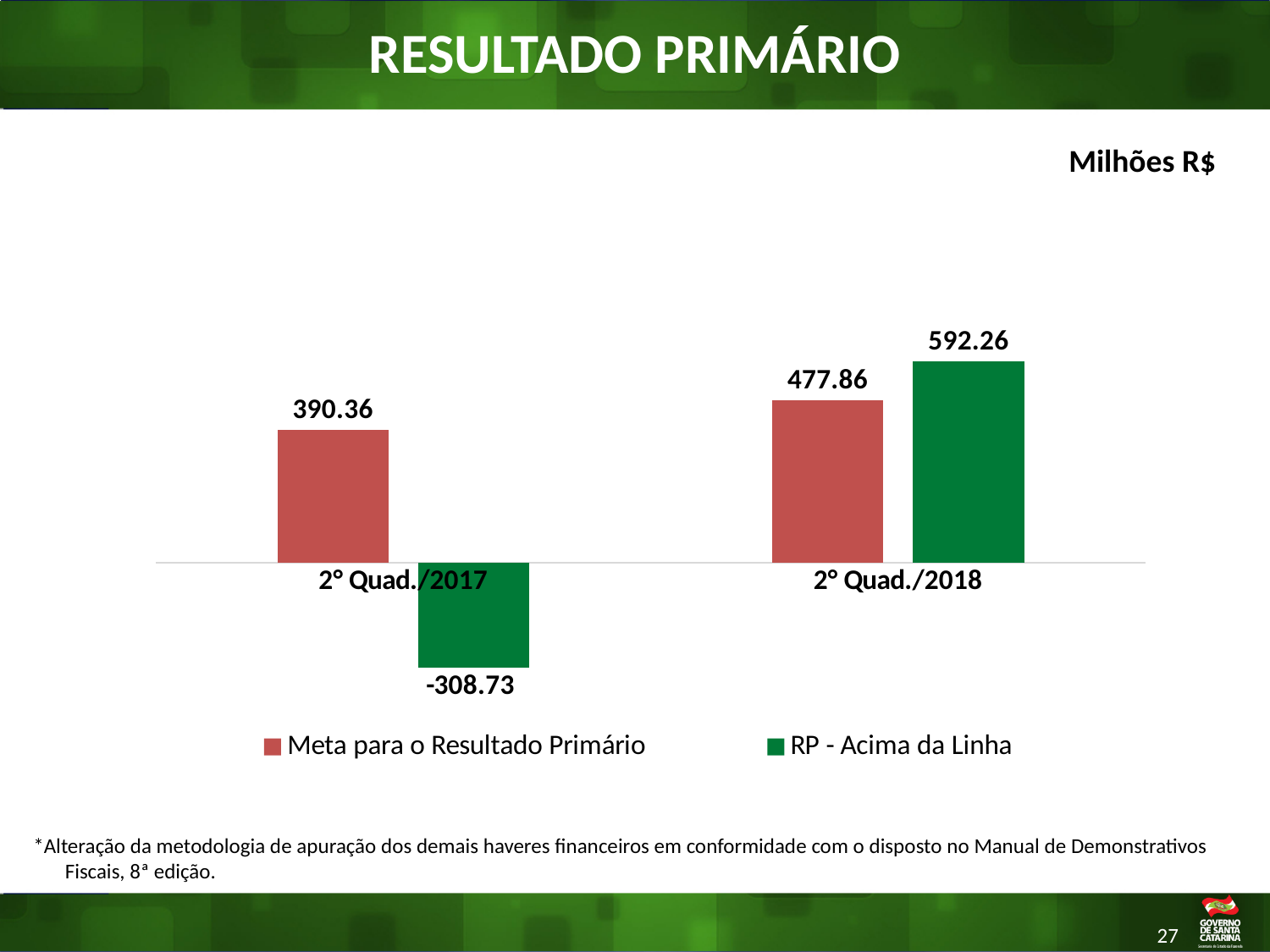
In 2° Quad./2017, which is larger: Meta para o Resultado Primário or RP - Acima da Linha? Meta para o Resultado Primário What is the difference between RP - Acima da Linha and Meta para o Resultado Primário in 2° Quad./2018? 114.40 How many series does the legend list? 2 What unit is indicated for the values on the chart? Milhões R$ What kind of chart is shown on the slide? Bar chart Which bar has the highest value on the chart? RP - Acima da Linha, 2° Quad./2018 Which bar has the lowest value on the chart? RP - Acima da Linha, 2° Quad./2017 What is the value of Meta para o Resultado Primário for 2° Quad./2018? 477.86 What is the value of Meta para o Resultado Primário for 2° Quad./2017? 390.36 What is the value of RP - Acima da Linha for 2° Quad./2018? 592.26 By how much did Meta para o Resultado Primário increase from 2° Quad./2017 to 2° Quad./2018? 87.50 What is the value of RP - Acima da Linha for 2° Quad./2017? -308.73